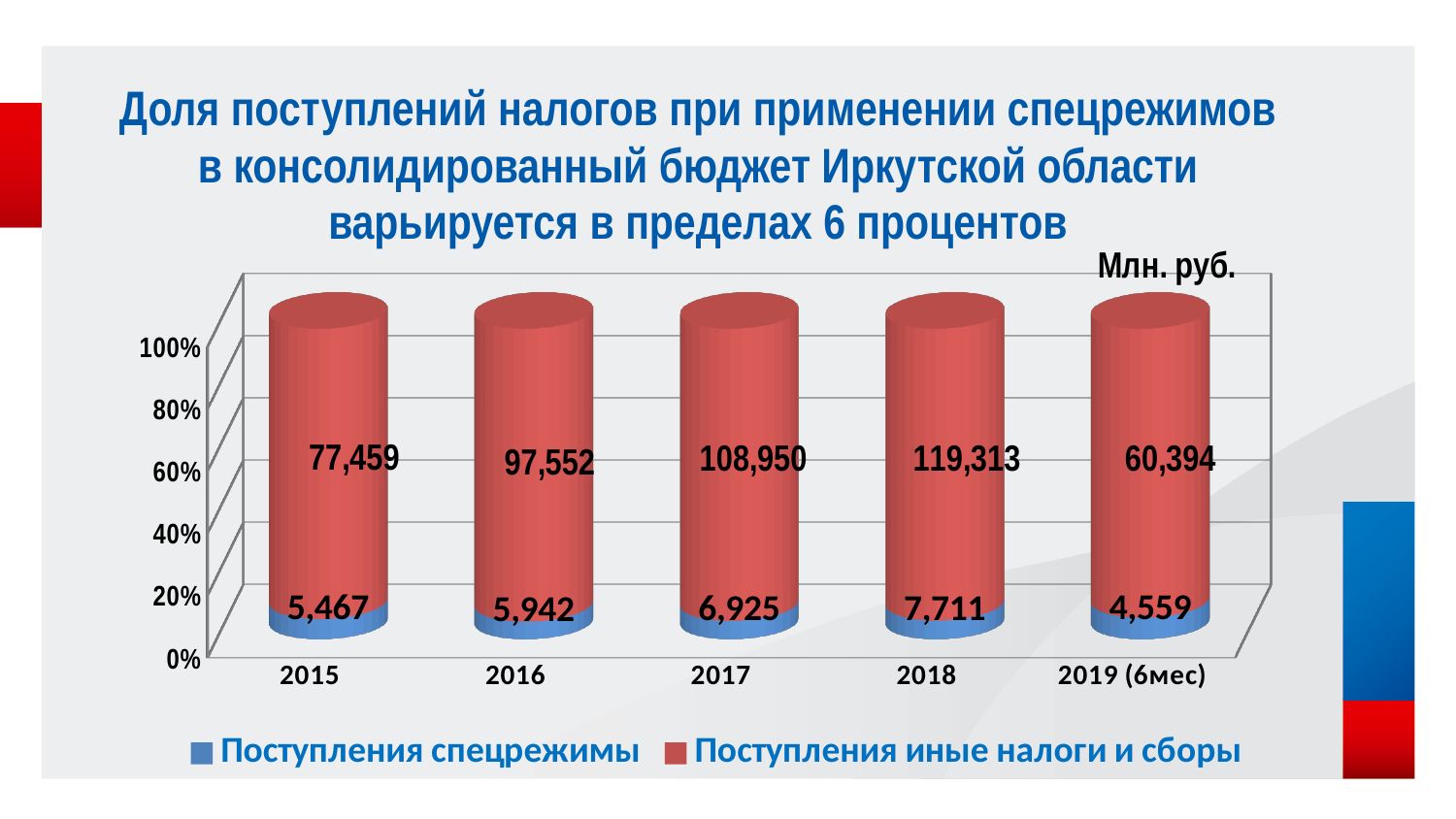
How many series does the legend list? 2 What is the value for 'Поступления спецрежимы' in 2019 (6мес)? 4,559 What is the difference between 'Поступления иные налоги и сборы' and 'Поступления спецрежимы' in 2018? 111,602 How many categories are shown on the x axis? 5 What kind of chart is shown on the slide? Stacked bar chart What is the value for 'Поступления иные налоги и сборы' in 2018? 119,313 Which year has the highest value for 'Поступления иные налоги и сборы'? 2018 What is the value for 'Поступления спецрежимы' in 2017? 6,925 Which is larger: 'Поступления спецрежимы' in 2016 or in 2017? 2017 What unit is indicated above the chart? Млн. руб. Which category has the lowest value for 'Поступления спецрежимы'? 2019 (6мес) Does the value for 'Поступления спецрежимы' rise or fall from 2015 to 2018? Rise